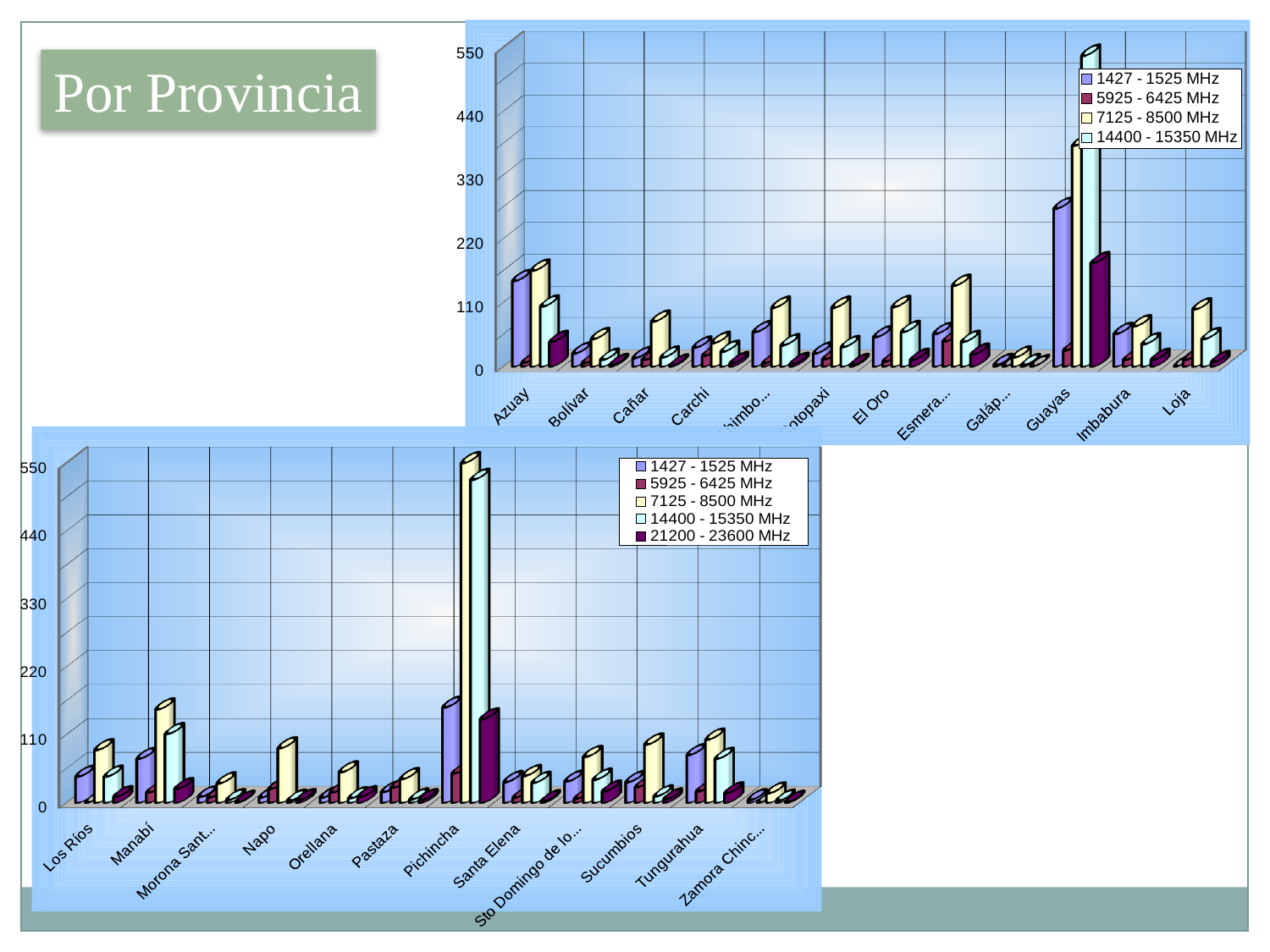
In the bottom chart, is the value for Pichincha in the 7125 - 8500 MHz series greater or less than 440? greater How many series does the legend of the bottom chart list? 5 In the top chart, which province has the tallest bar? Guayas In the top chart, is the value for Guayas in the 7125 - 8500 MHz series greater or less than 440? less How many provinces are shown on the x axis of the bottom chart? 12 How many provinces are shown on the x axis of the top chart? 12 How many series does the legend of the top chart list? 4 In the bottom chart, is the value for Zamora Chinc... in the 7125 - 8500 MHz series greater or less than 110? less What kind of chart is the top chart on the slide? bar chart In the bottom chart, which province has the tallest bar? Pichincha In the top chart, which is larger for the 7125 - 8500 MHz series: Guayas or Bolívar? Guayas What is the title shown on the slide? Por Provincia